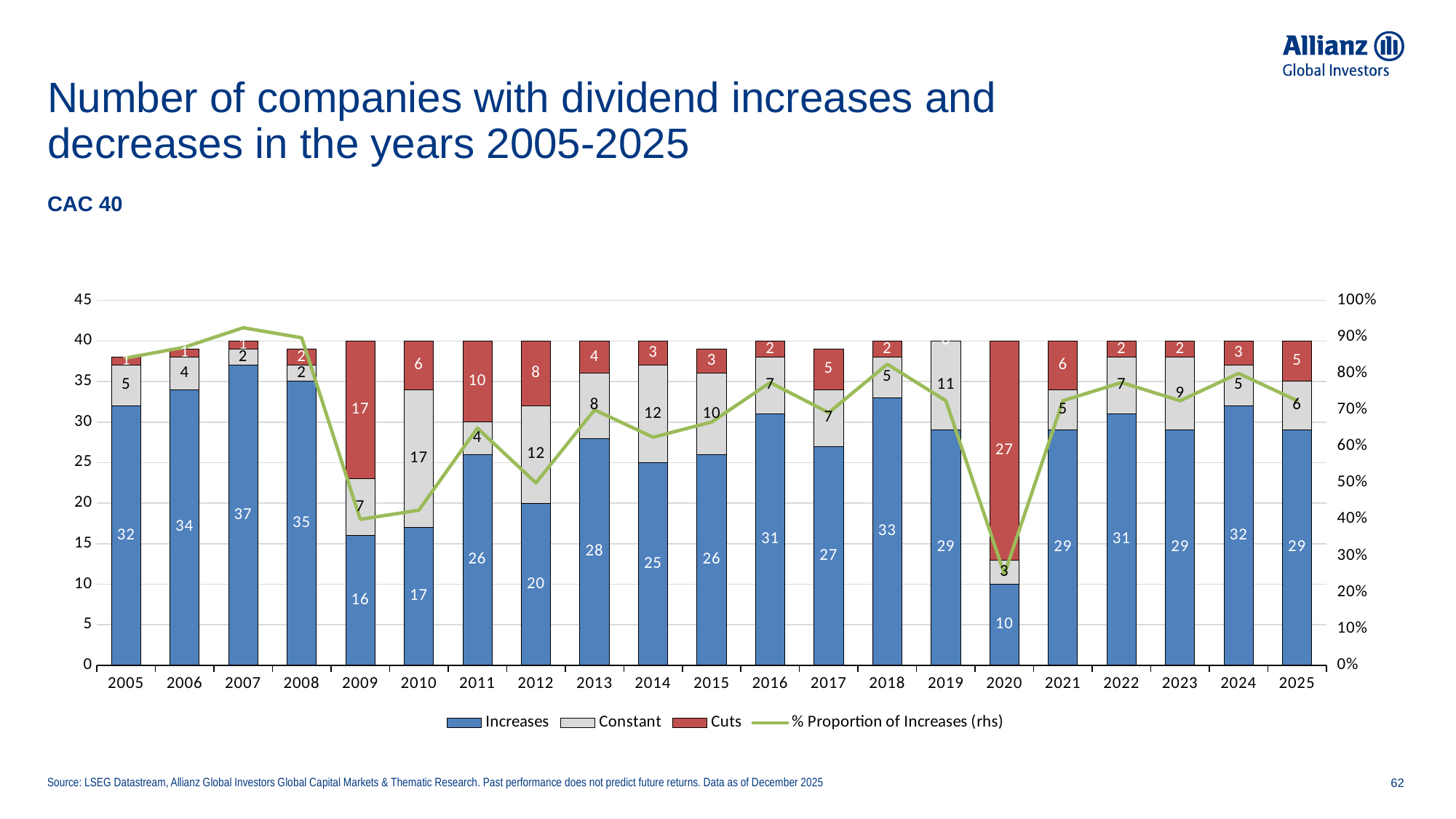
Is the % Proportion of Increases for 2020 greater or less than 30%? less How many companies in the CAC 40 had dividend increases in 2007? 37 In which year was the number of dividend cuts the highest? 2020 How many companies kept dividends constant in 2010? 17 How many series does the legend list? 4 How many years are shown on the x axis of the chart? 21 How many companies had dividend cuts in 2020? 27 What is the difference between the number of dividend increases in 2007 and in 2009? 21 In which year was the number of dividend increases the highest? 2007 What is the total number of companies shown in the stacked bar for 2012? 40 Which year had more dividend cuts, 2009 or 2011? 2009 In which year was the number of dividend increases the lowest? 2020